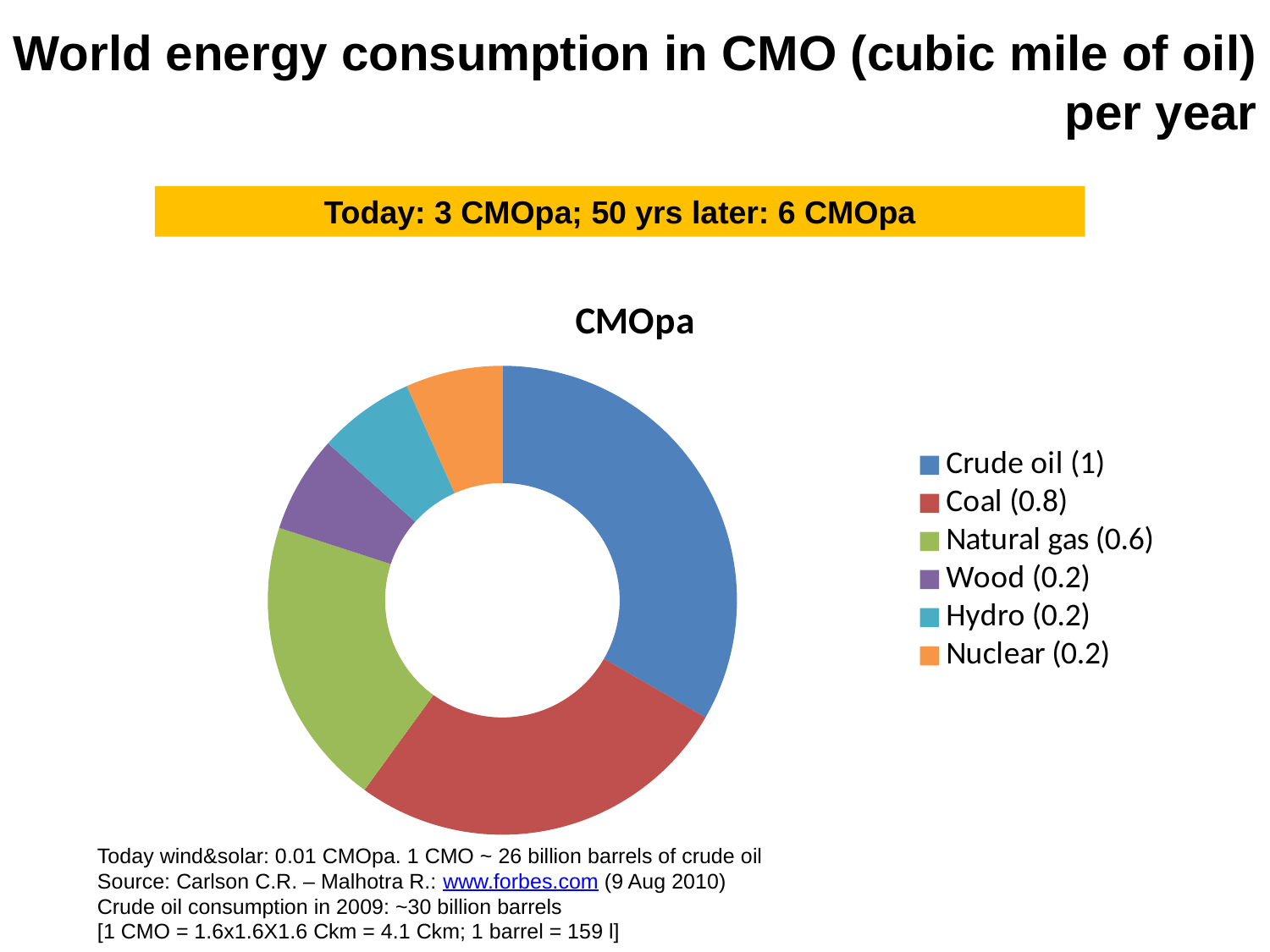
What is the value for Crude oil? 1 What is the value for Natural gas? 0.6 What kind of chart is shown on the slide? doughnut chart What share of the total does Natural gas represent? 20% How many categories does the chart show? 6 Which is larger, the value for Coal or the value for Natural gas? Coal Which categories share the lowest value? Wood, Hydro, Nuclear What is the value for Hydro? 0.2 What is the title of the chart? CMOpa Which category has the highest value? Crude oil What is the difference between the values for Crude oil and Natural gas? 0.4 What is the value for Coal? 0.8